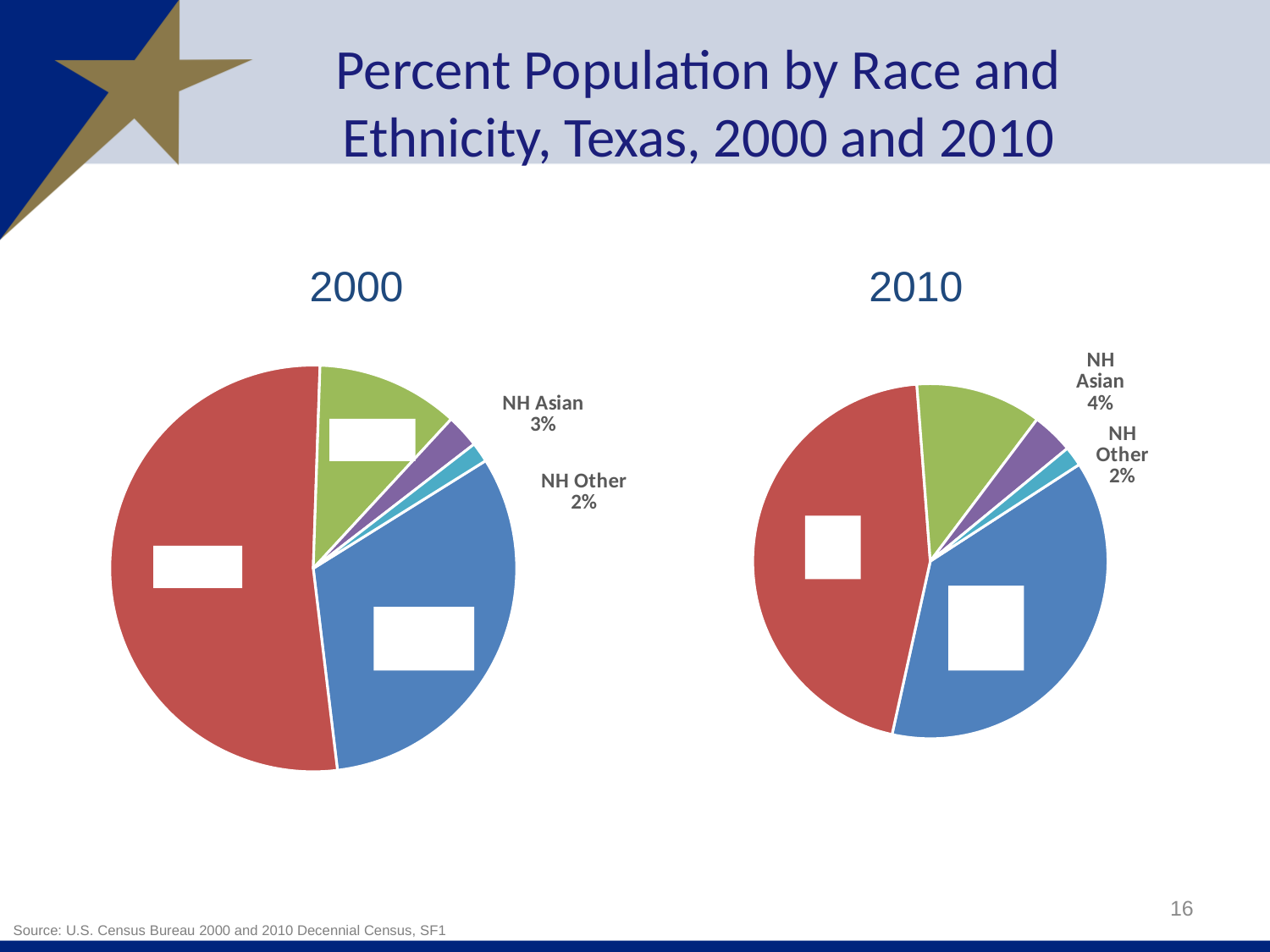
How many slices does the 2010 pie chart have? 5 In the 2010 pie chart, which labelled slice is the smallest? NH Other In the 2010 pie chart, what percentage is shown for NH Asian? 4% What is the title of the slide containing the two pie charts? Percent Population by Race and Ethnicity, Texas, 2000 and 2010 In the 2010 pie chart, which is larger, the NH Asian slice or the NH Other slice? NH Asian How many pie charts are shown on the slide? 2 In the 2000 pie chart, what percentage is shown for NH Asian? 3% In the 2000 pie chart, which is larger, the NH Asian slice or the NH Other slice? NH Asian By how many percentage points did the NH Asian share change from the 2000 pie chart to the 2010 pie chart? 1 percentage point In the 2010 pie chart, what percentage is shown for NH Other? 2% What kind of chart is used for the 2000 data? Pie chart In the 2000 pie chart, what percentage is shown for NH Other? 2%